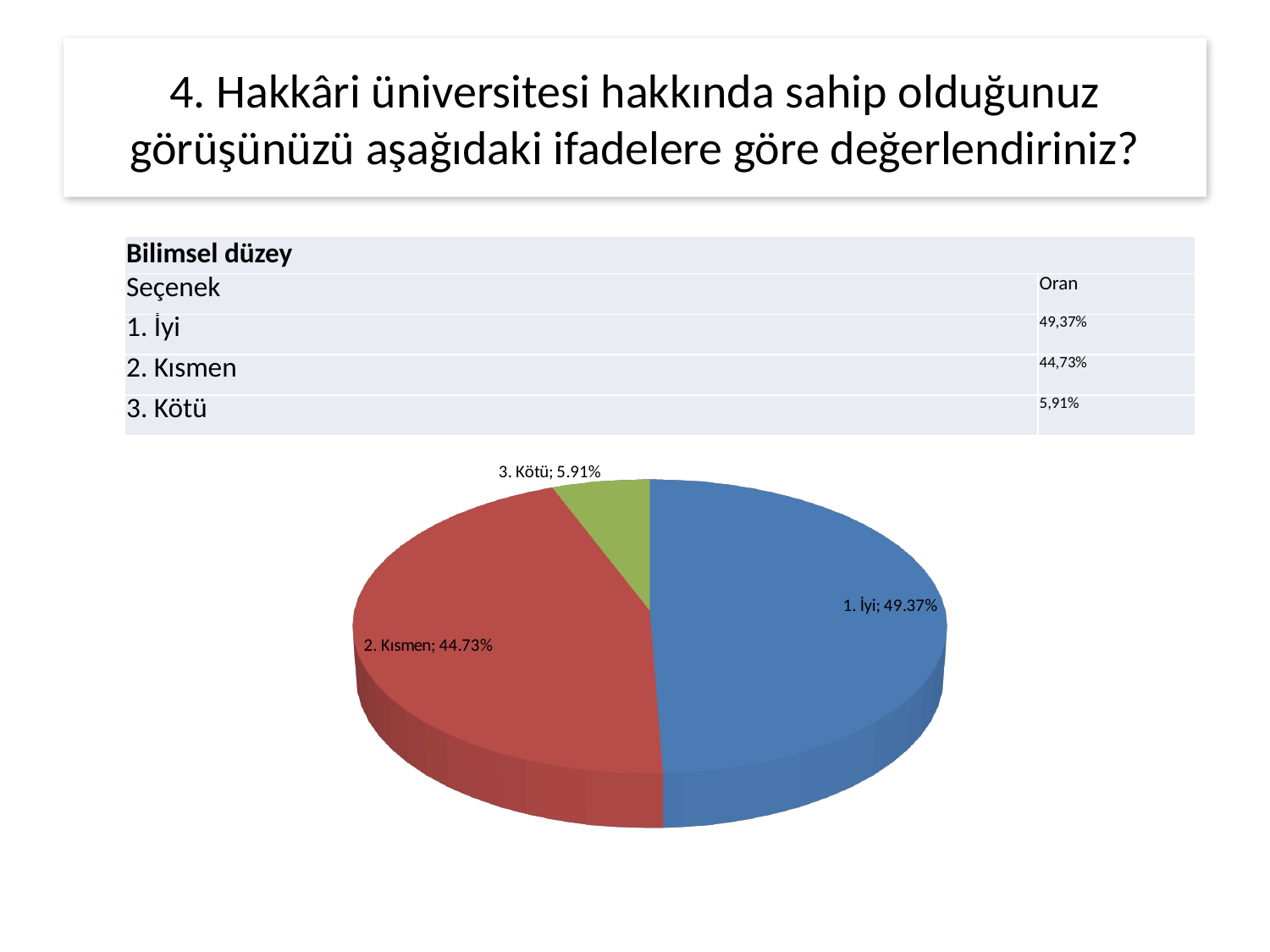
What is the value shown for the "2. Kısmen" slice in the pie chart? 44.73% What share of the pie does the "3. Kötü" slice represent? 5.91% Which category has the smallest slice in the pie chart? 3. Kötü How many slices does the pie chart have? 3 What is the difference between the values for "2. Kısmen" and "3. Kötü" in the pie chart? 38.82% Which is larger in the pie chart, the value for "2. Kısmen" or the value for "3. Kötü"? 2. Kısmen What colour is the "1. İyi" slice in the pie chart? Blue Which category has the largest slice in the pie chart? 1. İyi What is the value shown for the "3. Kötü" slice in the pie chart? 5.91% What kind of chart is shown on the slide? Pie chart What is the value shown for the "1. İyi" slice in the pie chart? 49.37% What is the difference between the values for "1. İyi" and "2. Kısmen" in the pie chart? 4.64%